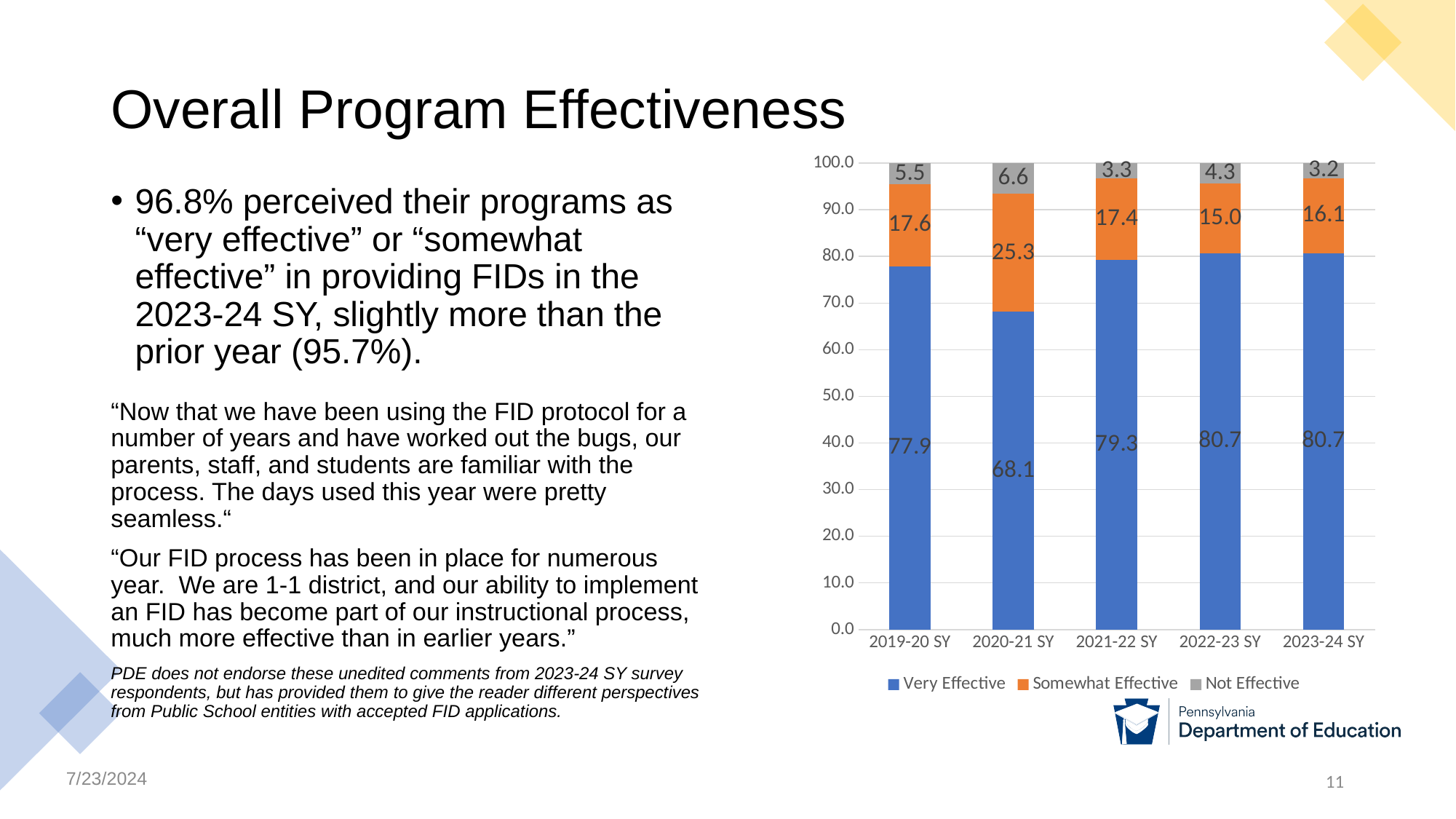
How many series does the legend list? 3 Is the Very Effective value for 2020-21 SY greater or less than 70.0? less What is the Very Effective value for 2020-21 SY? 68.1 Which school year has the highest Somewhat Effective value? 2020-21 SY What is the difference between the Somewhat Effective values for 2020-21 SY and 2019-20 SY? 7.7 What is the Somewhat Effective value for 2023-24 SY? 16.1 Is the Very Effective value for 2021-22 SY larger or smaller than for 2019-20 SY? larger What is the Not Effective value for 2019-20 SY? 5.5 How many school years are shown on the x axis? 5 What kind of chart is shown on the slide? stacked bar chart What is the total of the stacked bar for 2020-21 SY? 100.0 Which school year has the lowest Very Effective value? 2020-21 SY